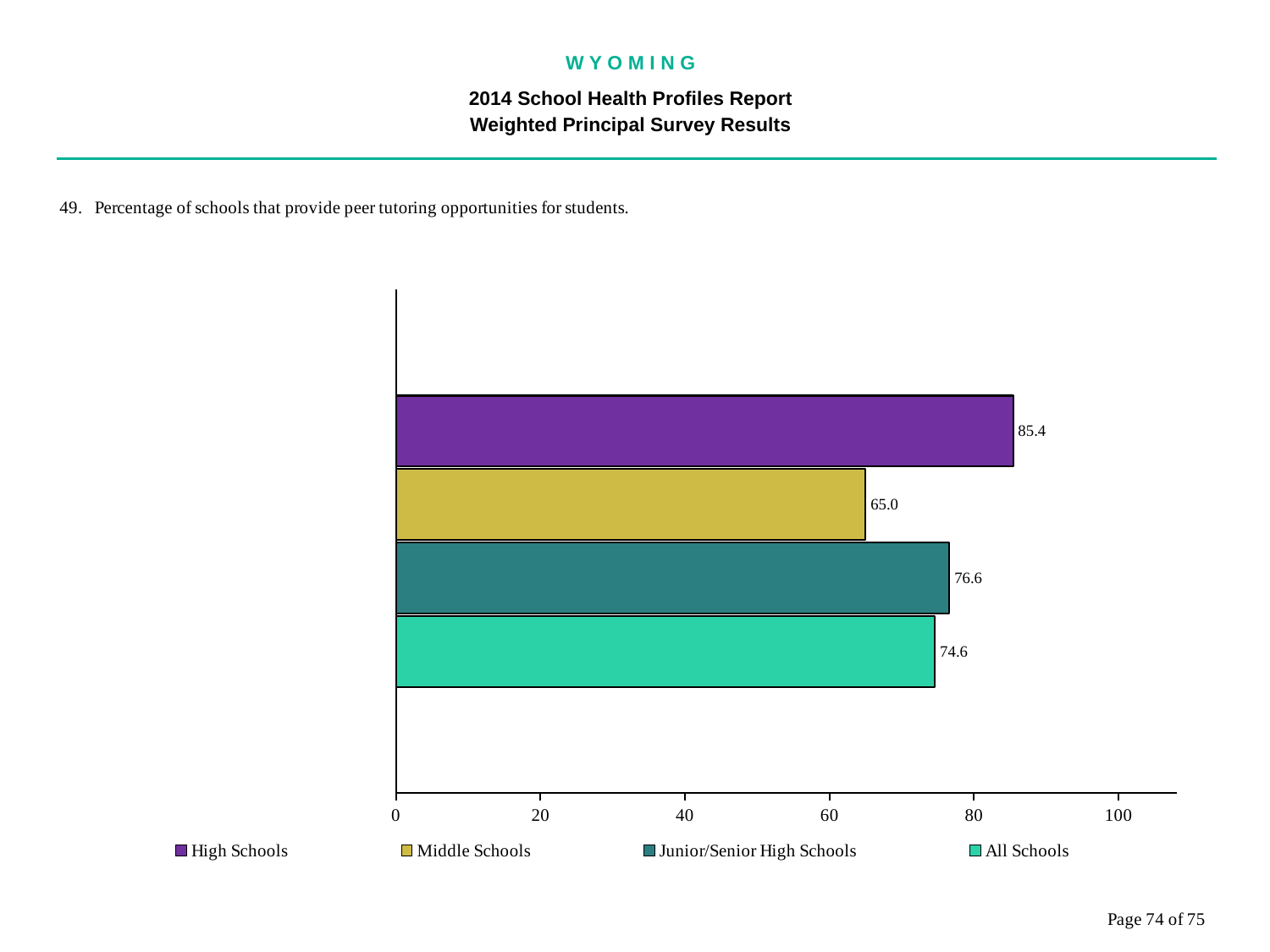
Which school type has the lowest percentage of schools providing peer tutoring opportunities? Middle Schools How many series does the legend list? 4 What kind of chart is shown on the slide? Bar chart What is the value for Middle Schools? 65.0 What is the difference between the values for High Schools and Middle Schools? 20.4 What is the value for All Schools? 74.6 What is the value for High Schools? 85.4 Is the value for Middle Schools greater or less than 60? greater What is the difference between the values for Junior/Senior High Schools and All Schools? 2.0 Which school type has the highest percentage of schools providing peer tutoring opportunities? High Schools Which is larger, the value for Junior/Senior High Schools or the value for Middle Schools? Junior/Senior High Schools What is the value for Junior/Senior High Schools? 76.6